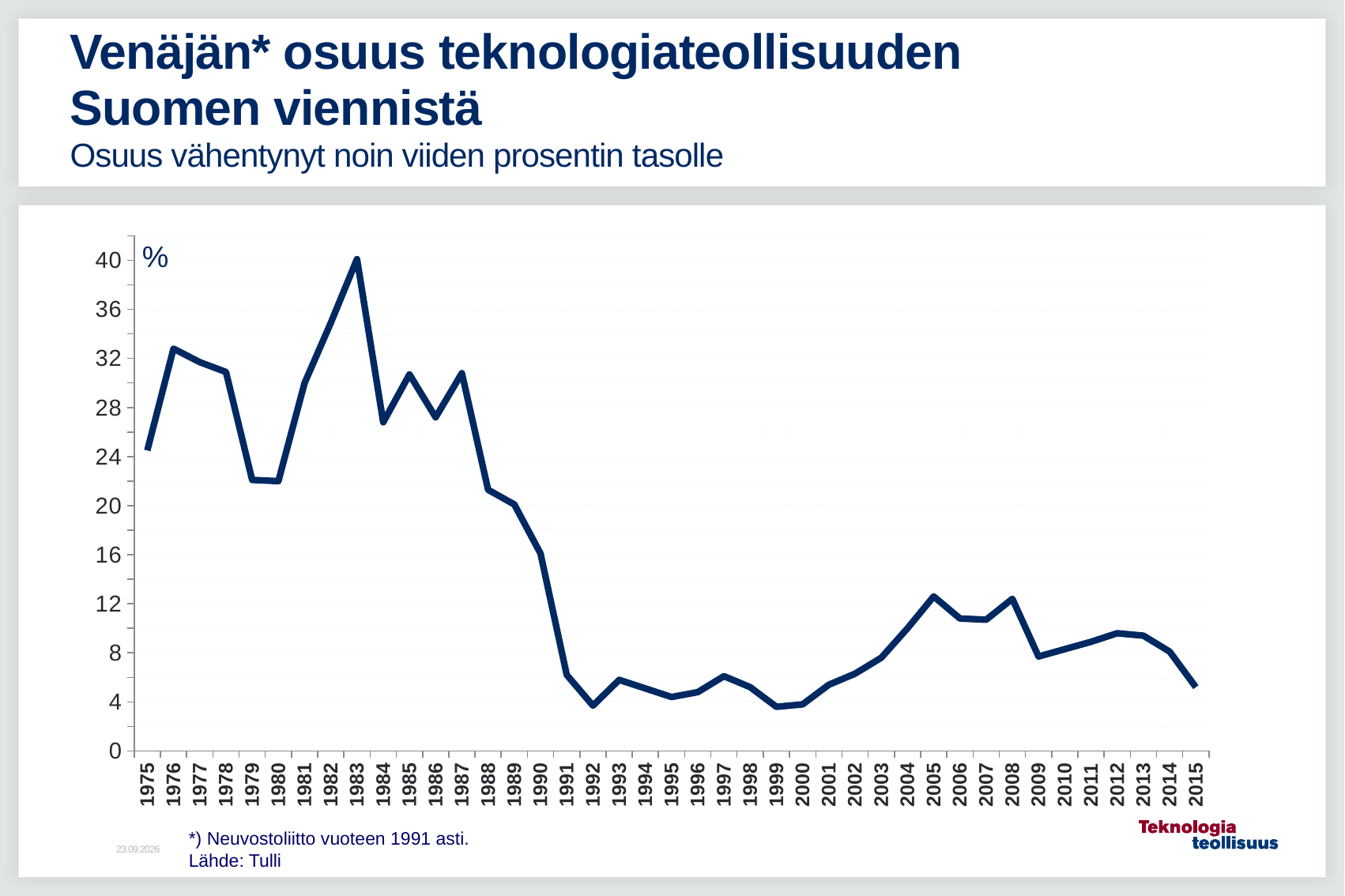
Which year has the larger value, 1976 or 1979? 1976 Is the value for 1979 greater or less than 20? greater Is the value for 2015 greater or less than 8? less Is the value for 1991 greater or less than 8? less What kind of chart is shown on the slide? line chart What unit is shown at the top of the y axis? % How many years are shown on the x axis? 41 Overall, does the value rise or fall from 1975 to 2015? fall Which year has the highest value on the chart? 1983 Which year has the larger value, 1985 or 1984? 1985